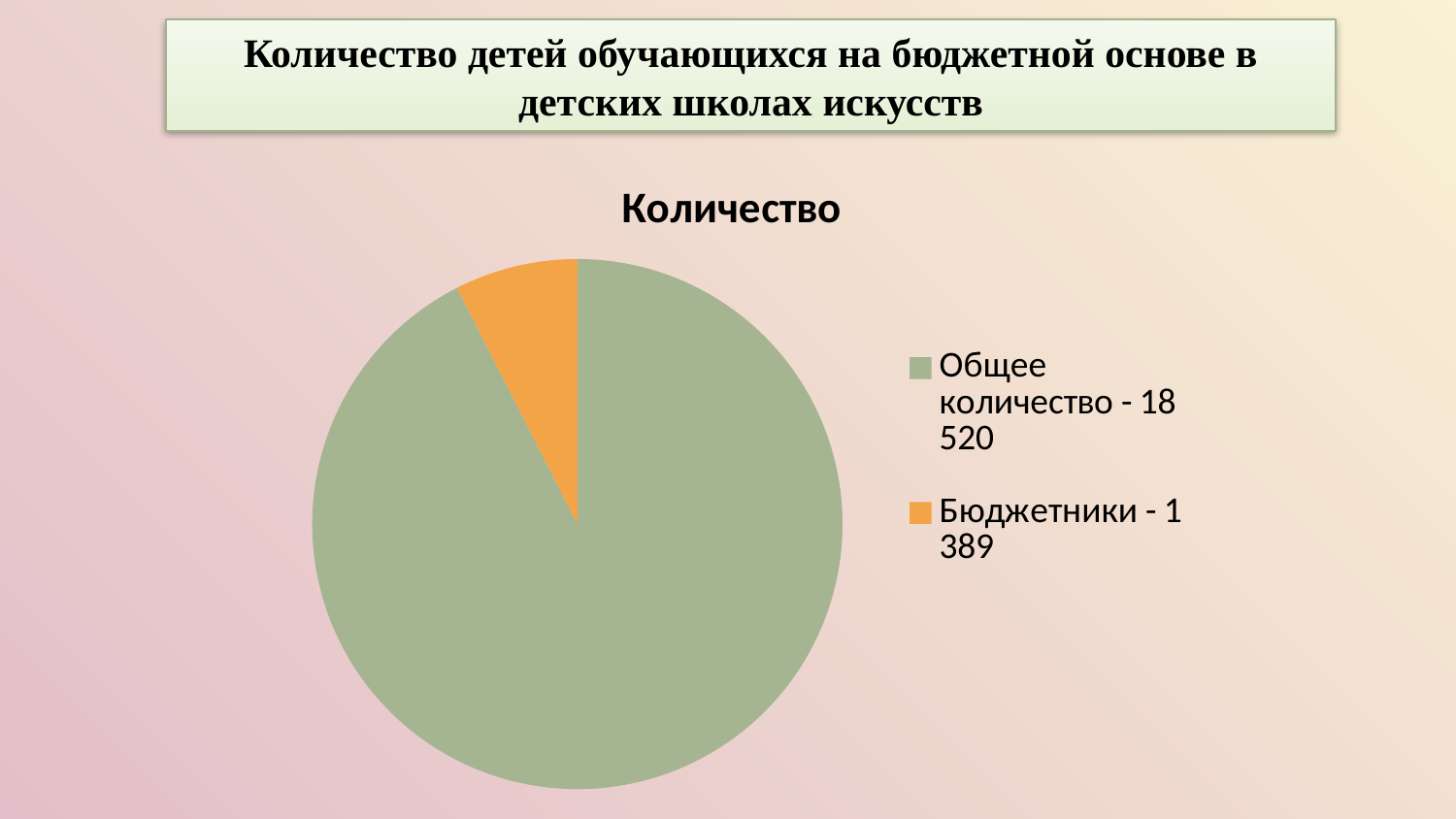
What is the title of the chart? Количество What value is given for "Общее количество" in the legend? 18 520 Which is larger: the value for "Общее количество" or the value for "Бюджетники"? Общее количество What kind of chart is shown on the slide? Pie chart Which category has the smaller slice of the pie? Бюджетники What is the difference between the value for "Общее количество" and the value for "Бюджетники"? 17 131 How many entries does the legend list? 2 What value is given for "Бюджетники" in the legend? 1 389 What colour is the slice for "Бюджетники"? Orange How many slices does the pie chart have? 2 Which category has the larger slice of the pie? Общее количество